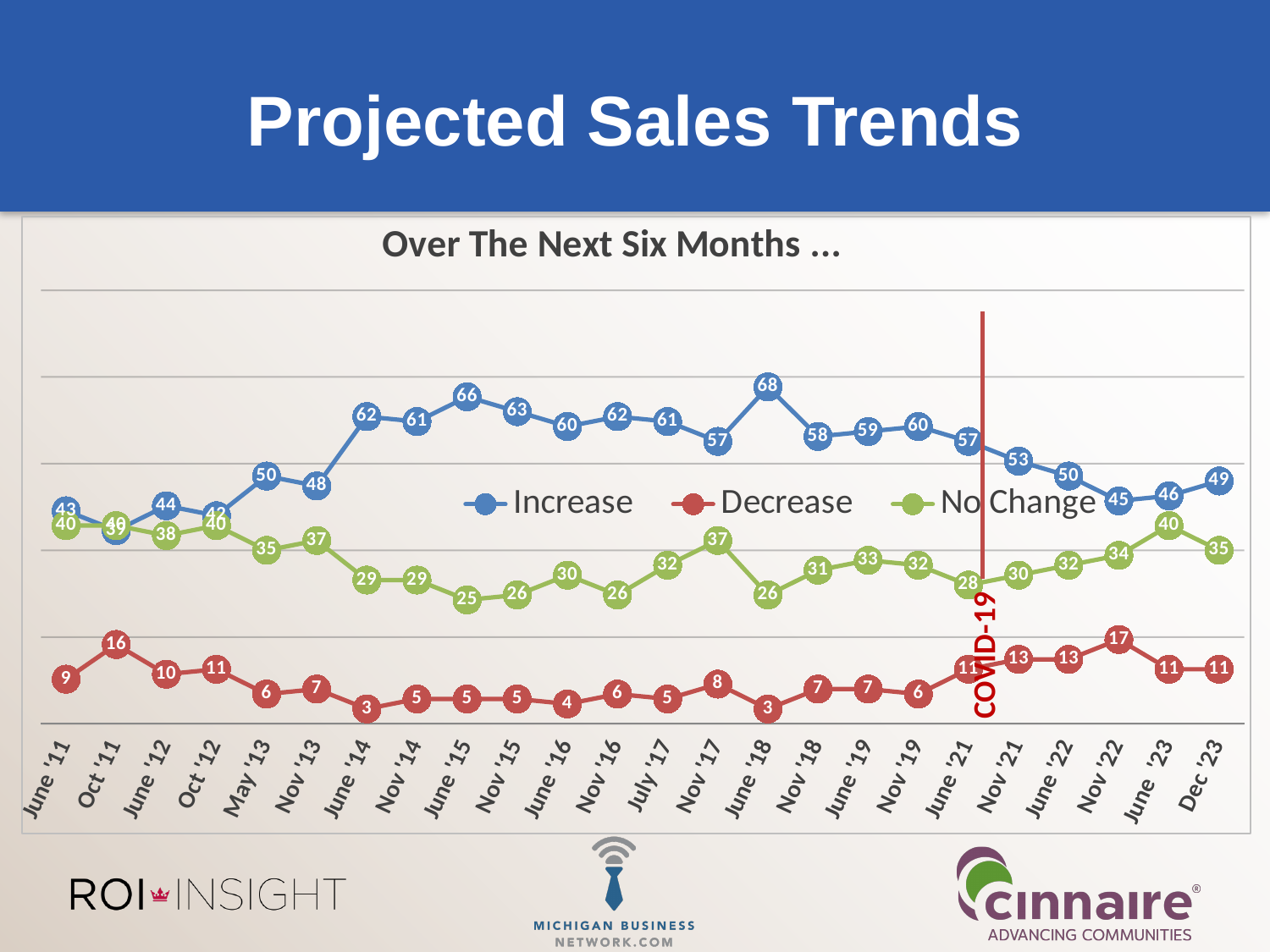
What kind of chart is shown on the slide? Line chart How many series does the legend list? 3 At which date does the No Change series reach its lowest value? June '15 What is the value of the Increase series at June '18? 68 At Dec '23, which is larger: the Increase value or the No Change value? Increase What is the difference between the Increase values at June '18 and Nov '18? 10 What is the value of the No Change series at June '15? 25 At which date does the Decrease series reach its highest value? Nov '22 Does the Increase series rise or fall from June '21 to Nov '22? Fall What is the value of the Decrease series at Nov '22? 17 At which date does the Increase series reach its highest value? June '18 How many dates are shown on the x axis? 24